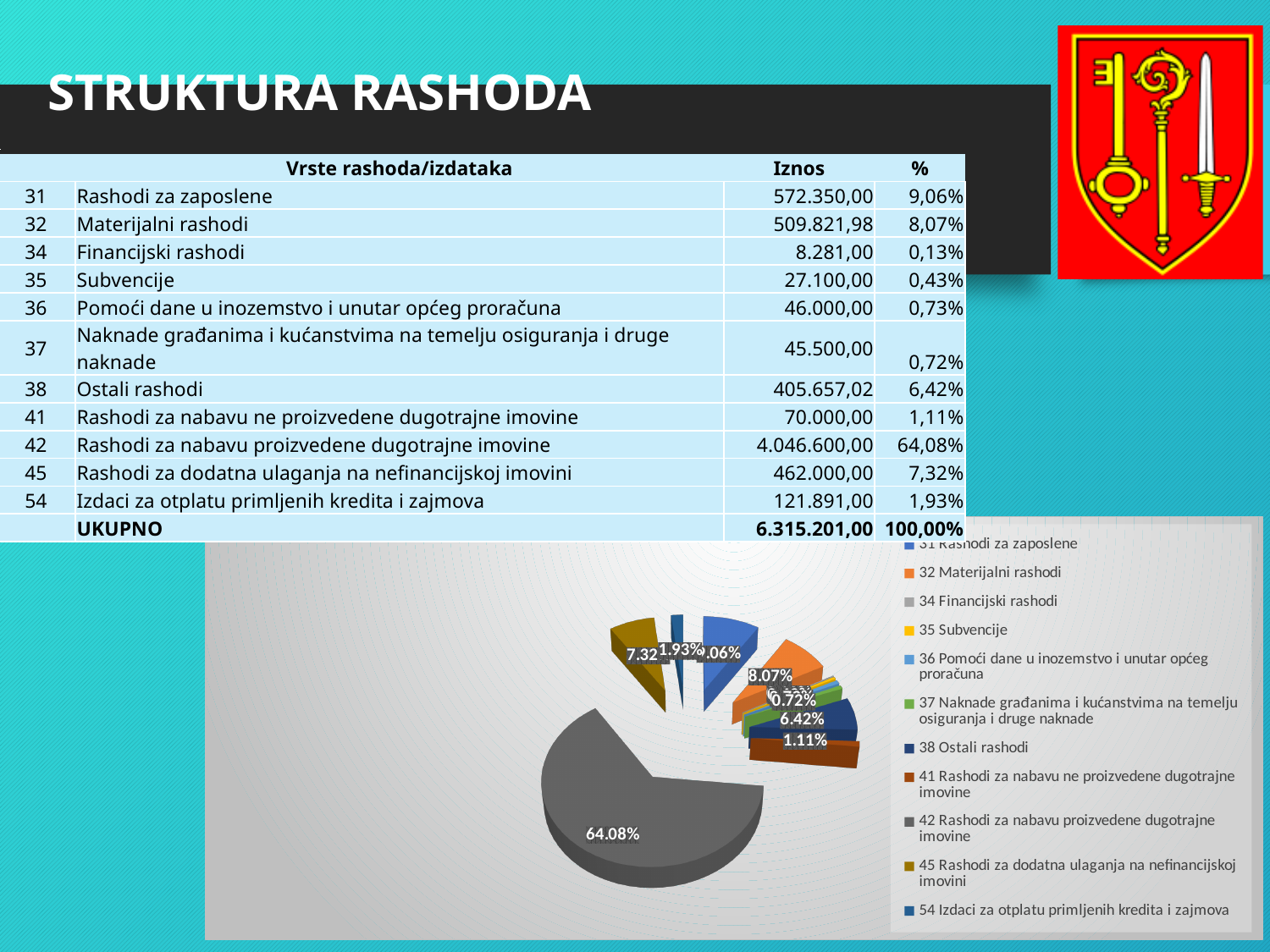
How many entries does the pie chart's legend list? 11 Which category is listed first in the pie chart's legend? 31 Rashodi za zaposlene What percentage label is shown on the pie chart for 32 Materijalni rashodi? 8.07% In the pie chart, which slice is larger: 32 Materijalni rashodi or 38 Ostali rashodi? 32 Materijalni rashodi What percentage label is shown on the pie chart for 41 Rashodi za nabavu ne proizvedene dugotrajne imovine? 1.11% What percentage label is shown on the pie chart for 38 Ostali rashodi? 6.42% What percentage label is shown on the pie chart for 45 Rashodi za dodatna ulaganja na nefinancijskoj imovini? 7.32% Which category has the largest slice in the pie chart? 42 Rashodi za nabavu proizvedene dugotrajne imovine What kind of chart is shown on the slide? pie chart What is the difference in percentage points between the 64.08% slice and the 8.07% slice in the pie chart? 56.01 In the pie chart, what share is labelled for the largest slice (42 Rashodi za nabavu proizvedene dugotrajne imovine)? 64.08% What percentage label is shown on the pie chart for 54 Izdaci za otplatu primljenih kredita i zajmova? 1.93%